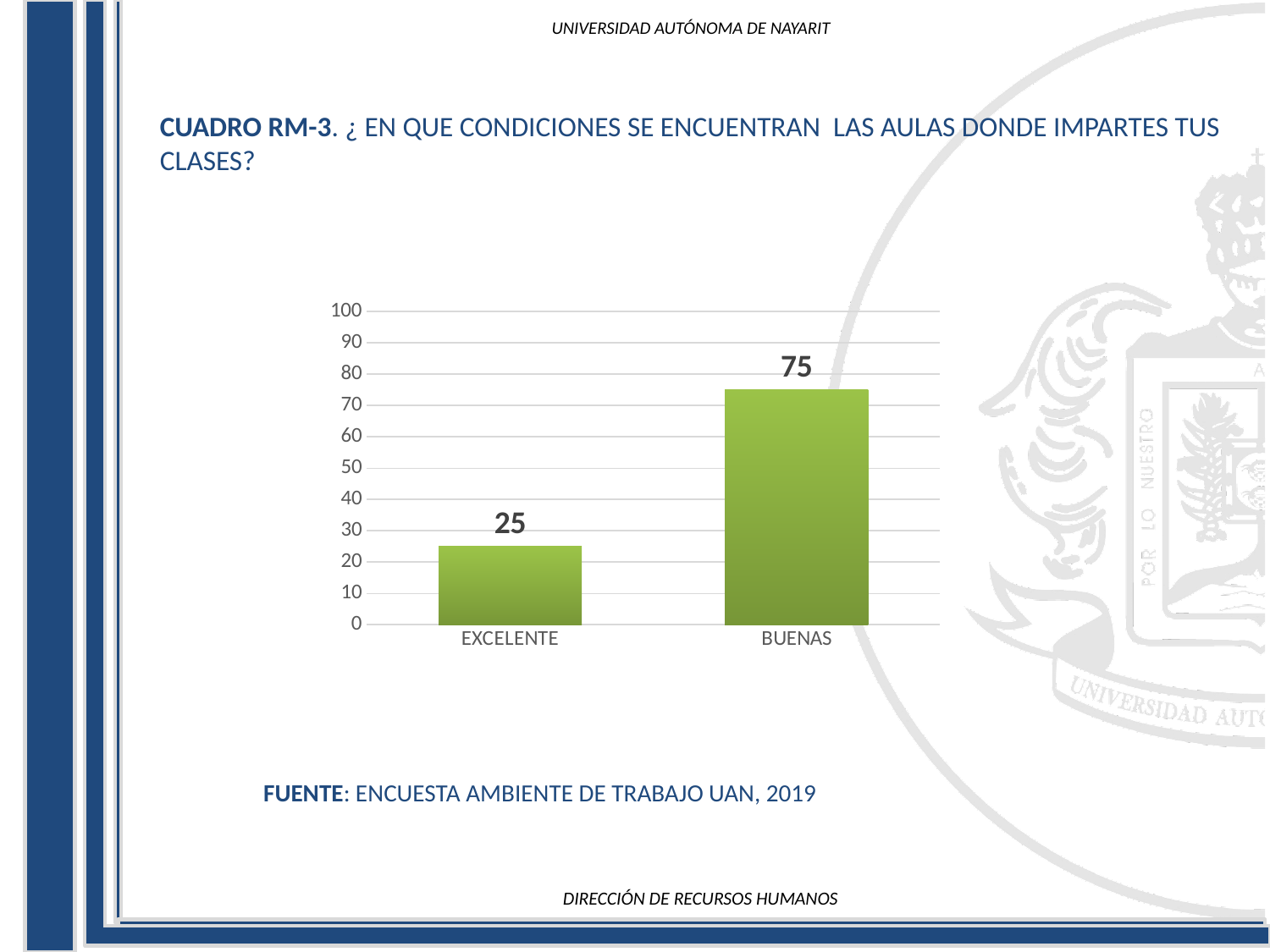
Is the value for BUENAS greater or less than 50? greater Which category has the highest value? BUENAS What is the difference between the values for BUENAS and EXCELENTE? 50 What is the value for EXCELENTE? 25 What colour are the bars in the chart? green What is the maximum value shown on the vertical axis? 100 Which category has the lowest value? EXCELENTE Is the value for EXCELENTE greater or less than 30? less What is the value for BUENAS? 75 How many categories are shown on the x axis? 2 What kind of chart is shown on the slide? bar chart Which is larger, the value for EXCELENTE or the value for BUENAS? BUENAS